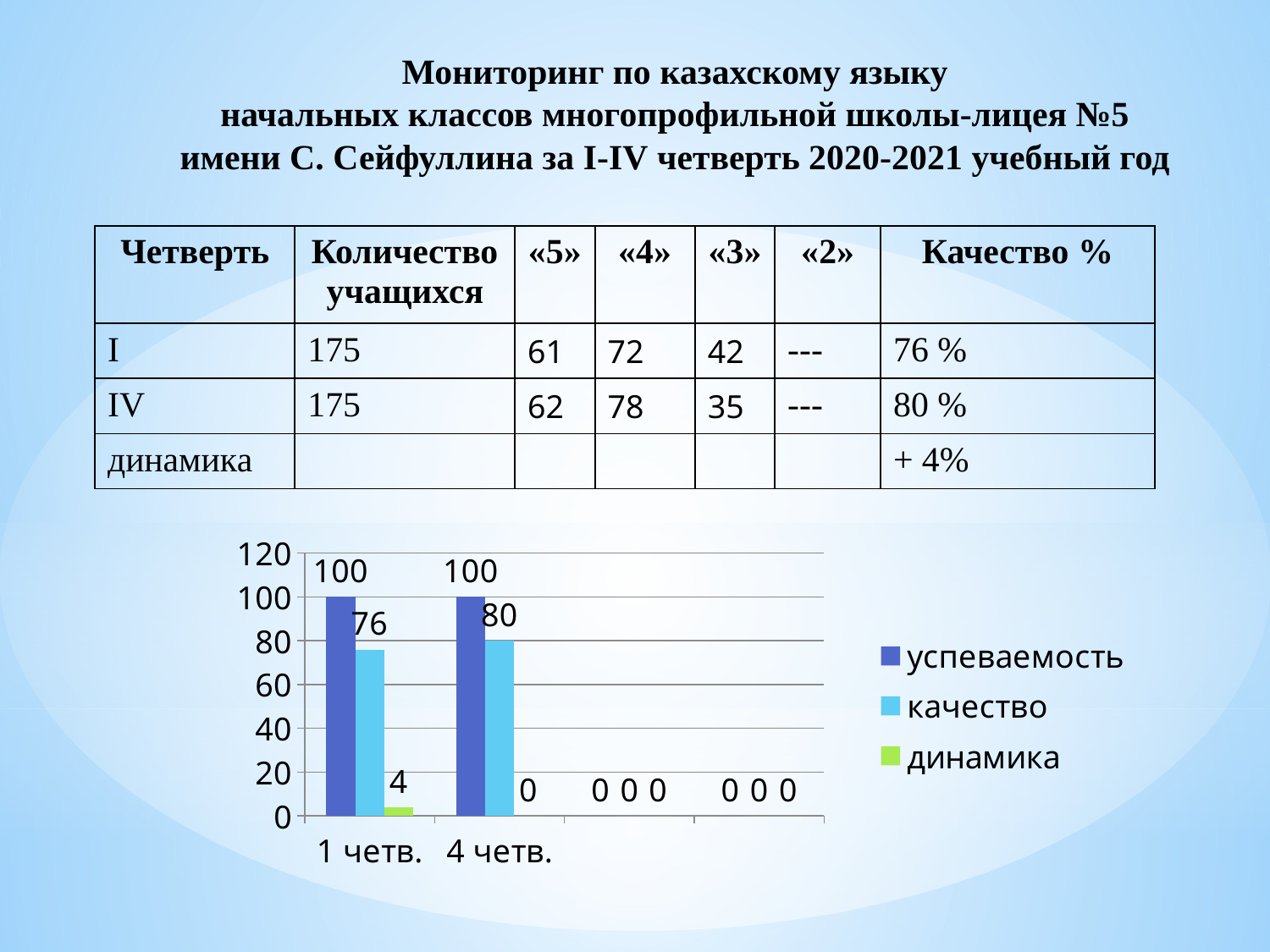
What is the value of успеваемость for 1 четв.? 100 By how much does качество for 4 четв. exceed качество for 1 четв.? 4 Which series has the highest value for 1 четв.? успеваемость What is the value of динамика for 1 четв.? 4 Does качество rise or fall from 1 четв. to 4 четв.? rise What is the value of качество for 1 четв.? 76 What is the value of динамика for 4 четв.? 0 How many series does the legend list? 3 What is the value of качество for 4 четв.? 80 What kind of chart is shown on the slide? bar chart Which is larger, качество for 1 четв. or качество for 4 четв.? 4 четв. Which series has the lowest value for 1 четв.? динамика